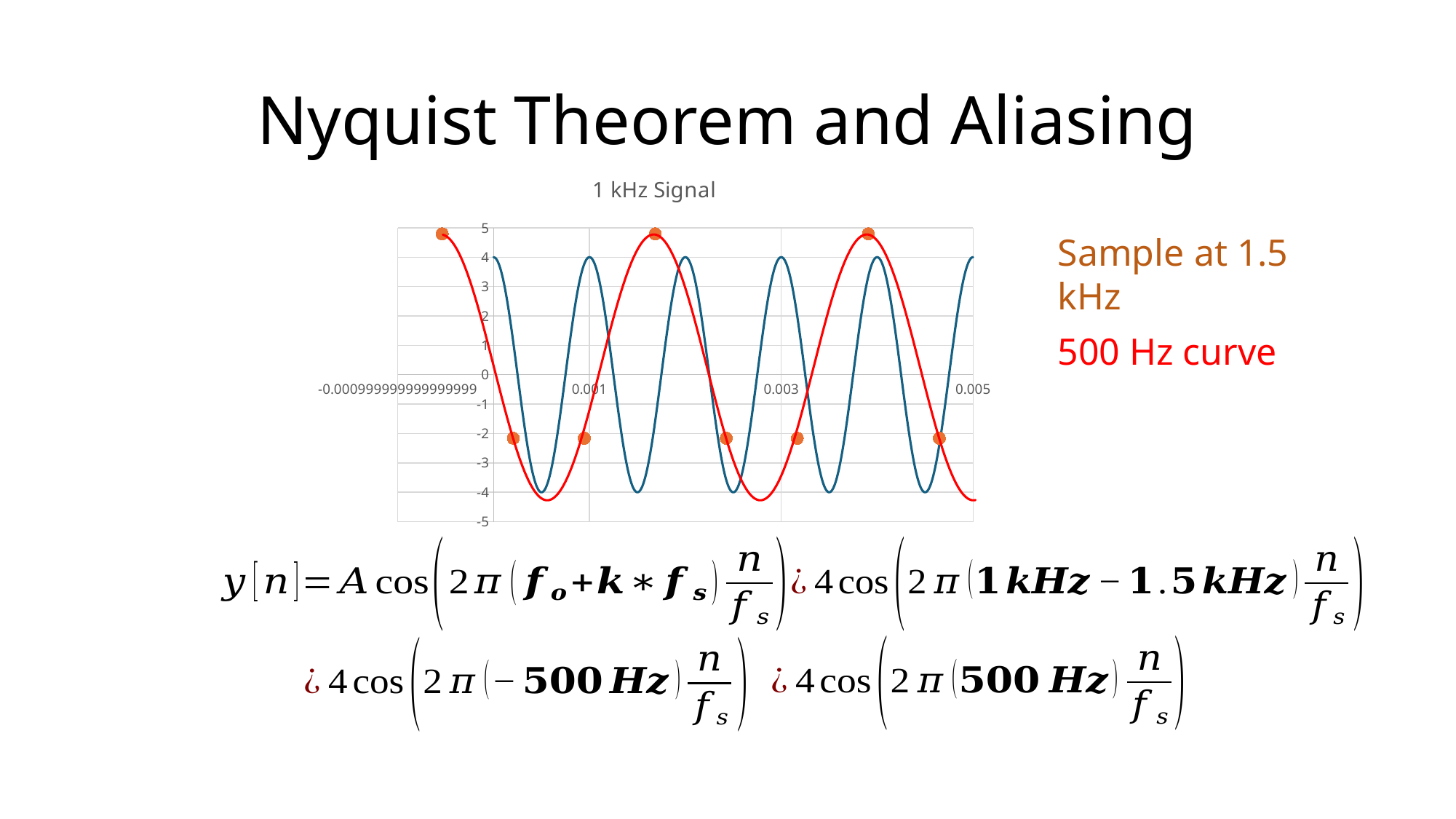
Is the peak value of the red curve greater or less than 4? greater Which curve completes more oscillations across the chart, the red curve or the blue curve? blue curve How many orange sample points are plotted on the chart? 8 What is the title of the chart? 1 kHz Signal What is the highest value shown on the chart's y axis? 5 What is the lowest value shown on the chart's y axis? -5 What is the rightmost tick label on the chart's x axis? 0.005 What kind of chart is shown on the slide? line chart Which curve reaches a higher peak value, the red curve or the blue curve? red curve Is the peak value of the blue curve greater or less than 3? greater What colour is the 500 Hz curve in the chart? red Is the value of the lower orange sample points greater or less than -3? greater